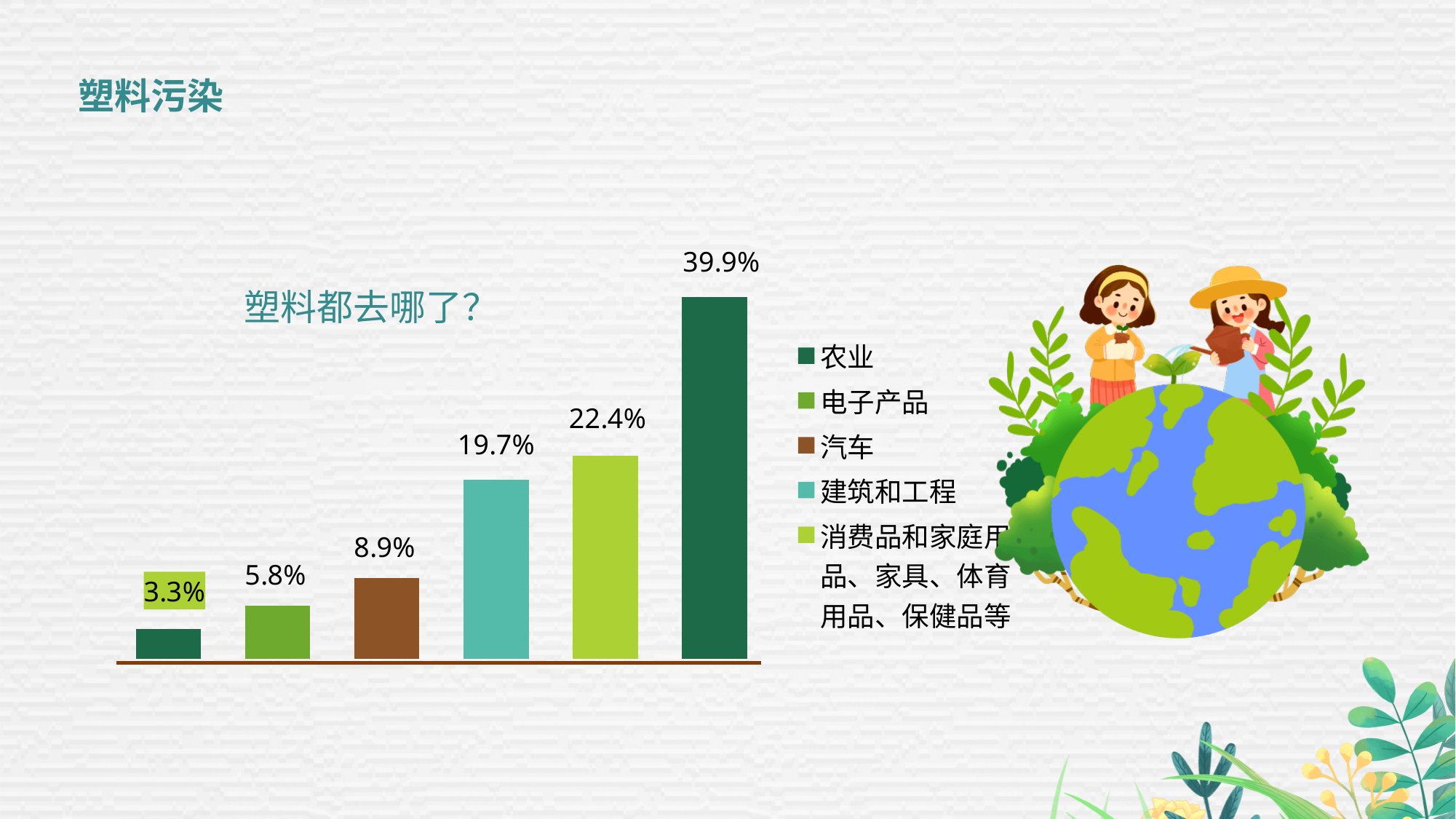
What kind of chart is shown on the slide? bar chart What is the value for 消费品和家庭用品、家具、体育用品、保健品等 (the light green bar)? 22.4% What is the value for 建筑和工程 (the teal bar)? 19.7% What is the difference between the values for 建筑和工程 and 汽车? 10.8% How many entries does the legend list? 5 What is the lowest value shown on the chart? 3.3% Which is larger, the value for 消费品和家庭用品、家具、体育用品、保健品等 or the value for 建筑和工程? 消费品和家庭用品、家具、体育用品、保健品等 What is the value for 汽车 (the brown bar)? 8.9% Do the bar values rise or fall from left to right? rise What is the value for 电子产品 (the green bar)? 5.8% How many bars are plotted on the chart? 6 What is the highest value shown on the chart? 39.9%